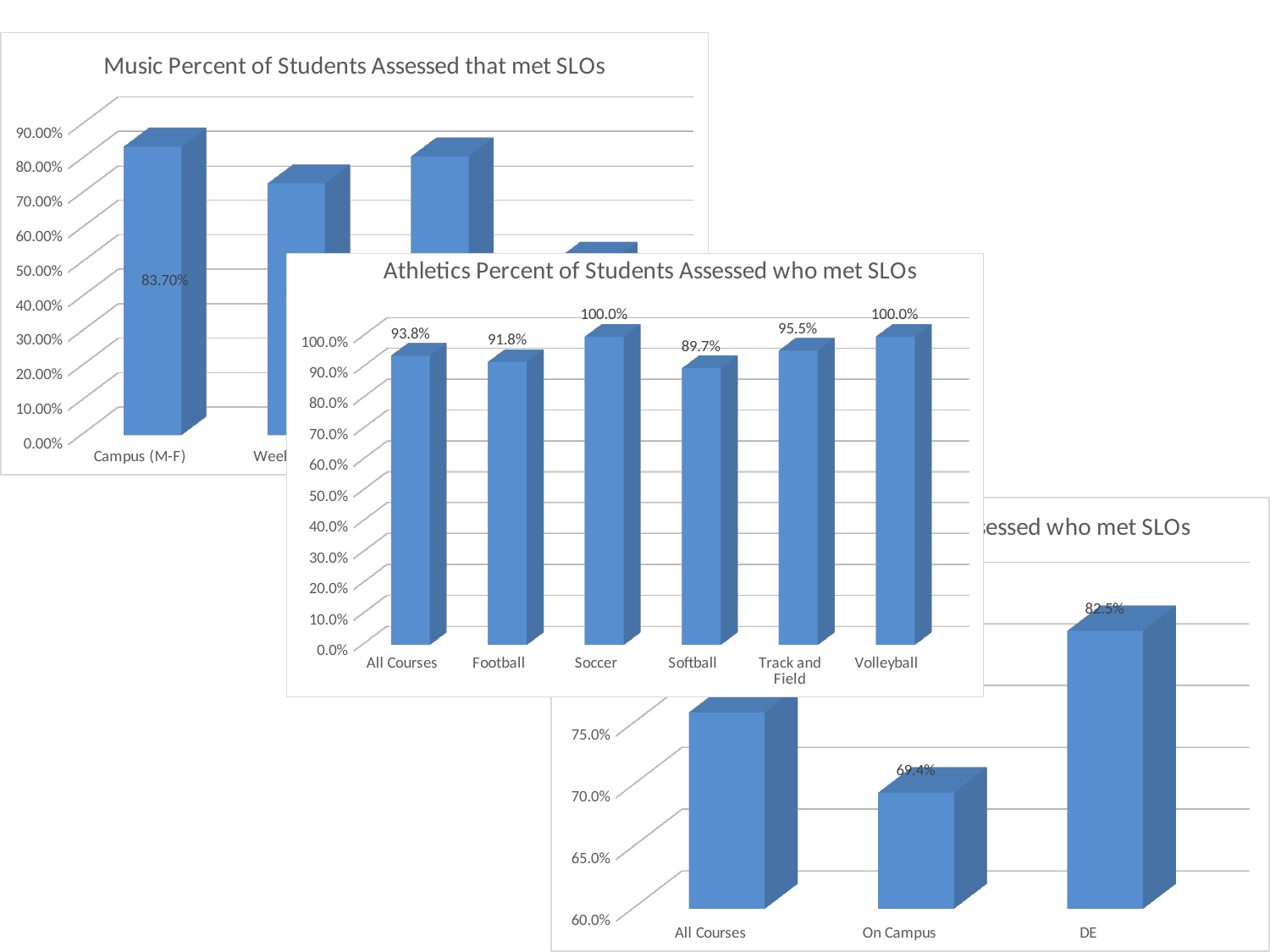
In the Athletics Percent of Students Assessed who met SLOs chart, what is the value for Track and Field? 95.5% In the Athletics Percent of Students Assessed who met SLOs chart, which is larger, Football or All Courses? All Courses In the Athletics Percent of Students Assessed who met SLOs chart, which category has the lowest value? Softball In the Athletics Percent of Students Assessed who met SLOs chart, what is the difference between Track and Field and Softball? 5.8% How many categories are shown in the Athletics Percent of Students Assessed who met SLOs chart? 6 In the bottom-right chart, what is the value for On Campus? 69.4% What type of chart is the Athletics Percent of Students Assessed who met SLOs chart? Bar chart In the Athletics Percent of Students Assessed who met SLOs chart, which categories reach 100.0%? Soccer and Volleyball In the Athletics Percent of Students Assessed who met SLOs chart, what is the value for Football? 91.8% In the Athletics Percent of Students Assessed who met SLOs chart, what is the value for All Courses? 93.8% In the Music Percent of Students Assessed that met SLOs chart, what is the value for Campus (M-F)? 83.70% In the bottom-right chart, what is the value for DE? 82.5%